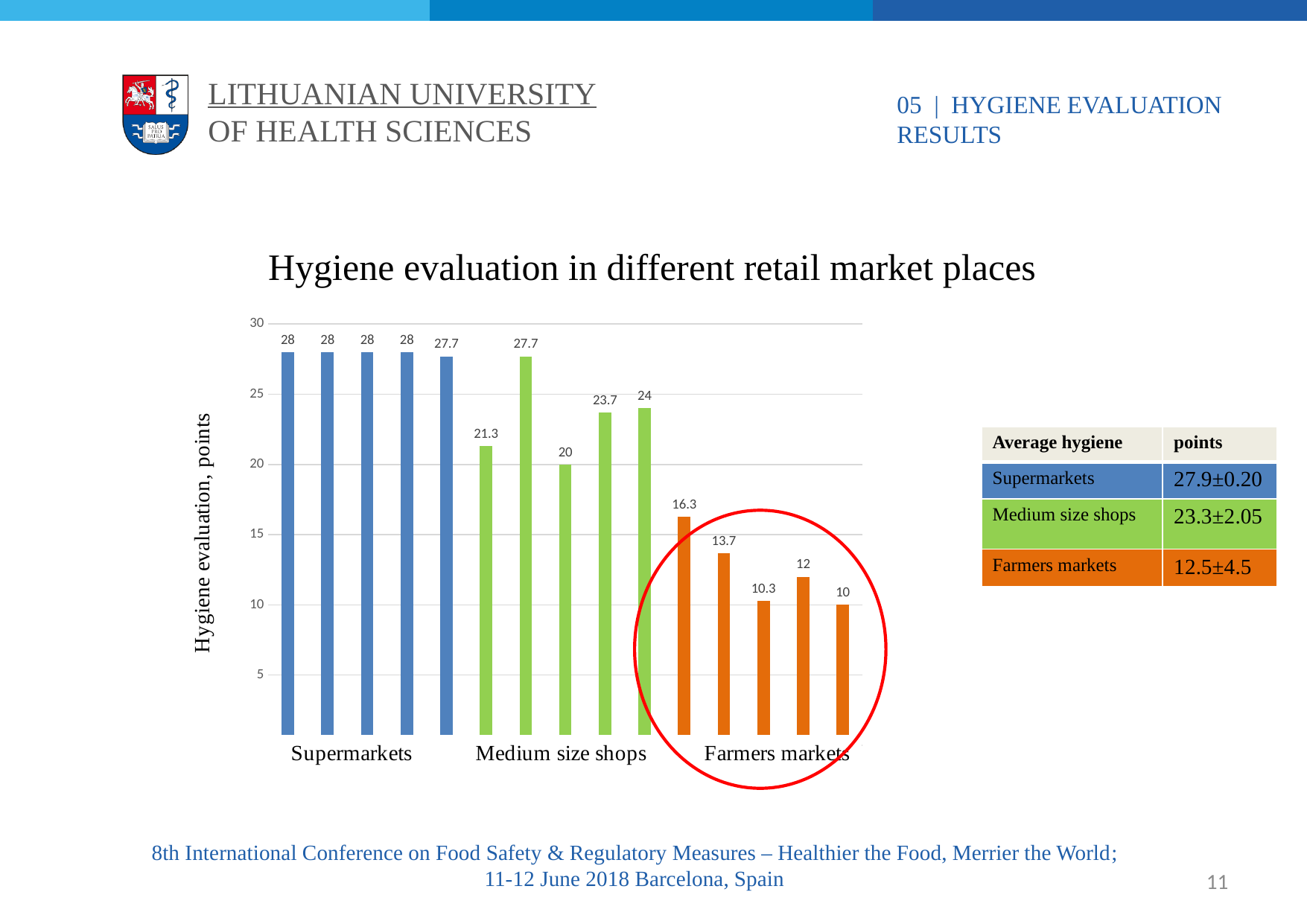
How many bars are plotted in the Farmers markets group? 5 What kind of chart is shown on the slide? Bar chart What is the title of the chart? Hygiene evaluation in different retail market places What is the value of the first bar in the Farmers markets group? 16.3 What is the value of the last bar in the Supermarkets group? 27.7 How many retail market place categories are shown on the x axis of the chart? 3 Which is larger: the third bar in the Medium size shops group (20) or the first bar in the Farmers markets group (16.3)? Medium size shops (20) What is the difference between the highest (27.7) and lowest (20) bars in the Medium size shops group? 7.7 Is the value of the second bar in the Farmers markets group greater or less than 15? less What is the highest value plotted in the Medium size shops group? 27.7 What colour are the bars for the Farmers markets group? Orange What is the lowest value plotted in the chart? 10